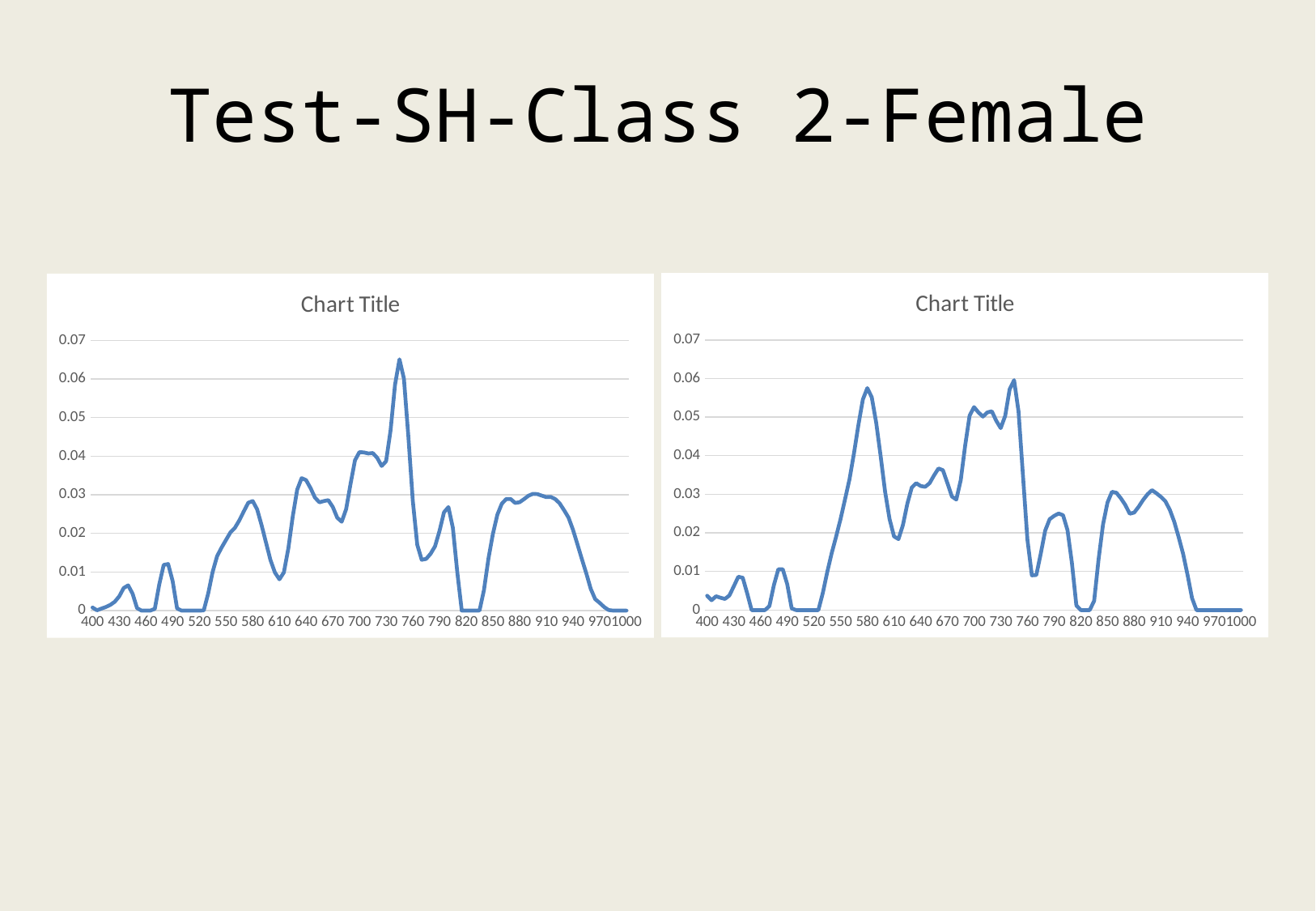
In the right chart, is the value at 580 greater or less than 0.05? greater In the left chart, is the value at 580 greater or less than 0.02? greater What is the title shown on the left chart? Chart Title In the right chart, what is the value at 520? 0 In the left chart, is the highest point of the line greater or less than 0.06? greater In the right chart, which is larger, the value at 580 or the value at 610? 580 In the left chart, what is the value at 820? 0 In the right chart, do the values rise or fall from 910 to 1000? fall What kind of chart is the chart on the left? line chart How many charts are on the slide? 2 What kind of chart is the chart on the right? line chart